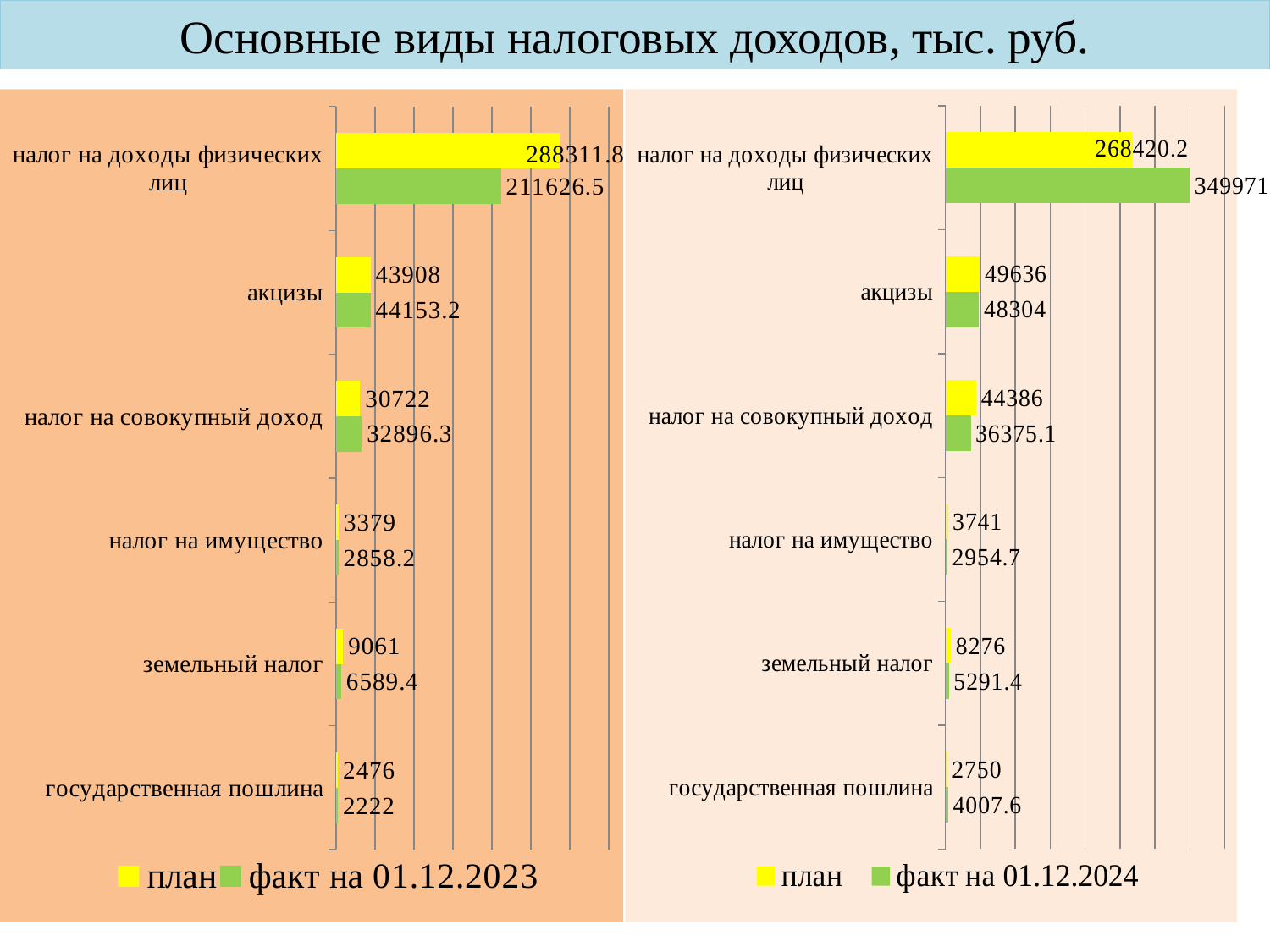
In the left chart (факт на 01.12.2023), what is the план value for налог на доходы физических лиц? 288311.8 What type of chart is the left chart (факт на 01.12.2023)? bar chart In the right chart (факт на 01.12.2024), what is the факт value for налог на доходы физических лиц? 349971 In the right chart (факт на 01.12.2024), which is larger for государственная пошлина: план or факт? факт In the left chart (факт на 01.12.2023), what is the difference between the план and факт values for земельный налог? 2471.6 In the right chart (факт на 01.12.2024), what is the difference between the факт and план values for налог на доходы физических лиц? 81550.8 In the right chart (факт на 01.12.2024), which category has the highest план value? налог на доходы физических лиц How many series does the legend of the right chart (факт на 01.12.2024) list? 2 How many categories are shown in the left chart (факт на 01.12.2023)? 6 In the right chart (факт на 01.12.2024), what is the план value for налог на совокупный доход? 44386 In the left chart (факт на 01.12.2023), what is the факт value for акцизы? 44153.2 In the left chart (факт на 01.12.2023), which category has the lowest факт value? государственная пошлина